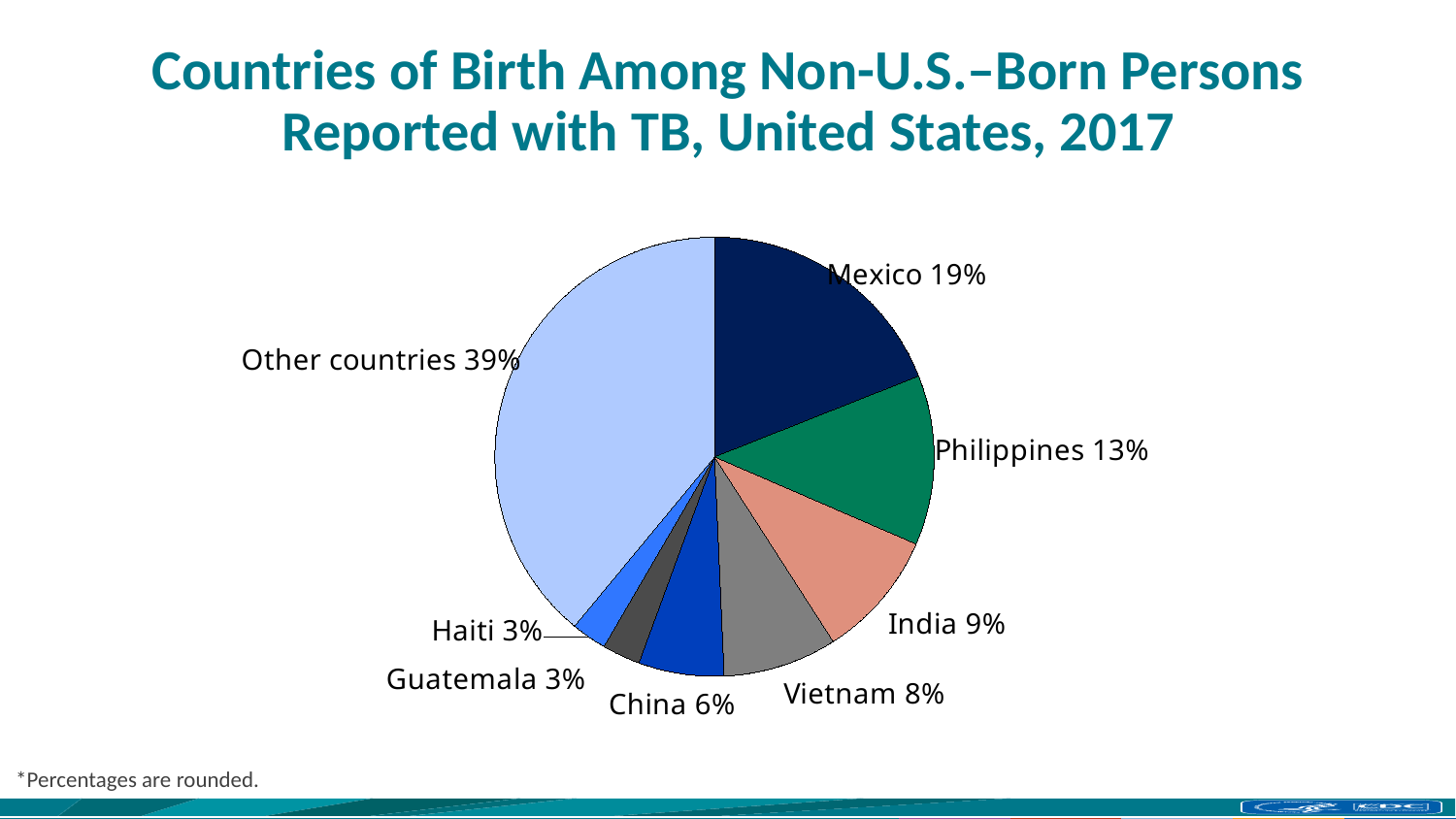
Which named country (excluding 'Other countries') has the largest slice? Mexico How many slices does the pie chart have? 8 Which is larger, the slice for India or the slice for China? India What percentage does the Philippines slice represent? 13% What percentage of non-U.S.-born persons reported with TB were born in Mexico? 19% What is the difference in percentage points between Mexico and the Philippines? 6 What type of chart is shown on the slide? Pie chart What is the combined percentage for Guatemala and Haiti? 6% What is the value shown for Vietnam? 8% Which slice is the largest in the pie chart? Other countries What share of the pie is labelled 'Other countries'? 39% What is the title of the chart? Countries of Birth Among Non-U.S.–Born Persons Reported with TB, United States, 2017